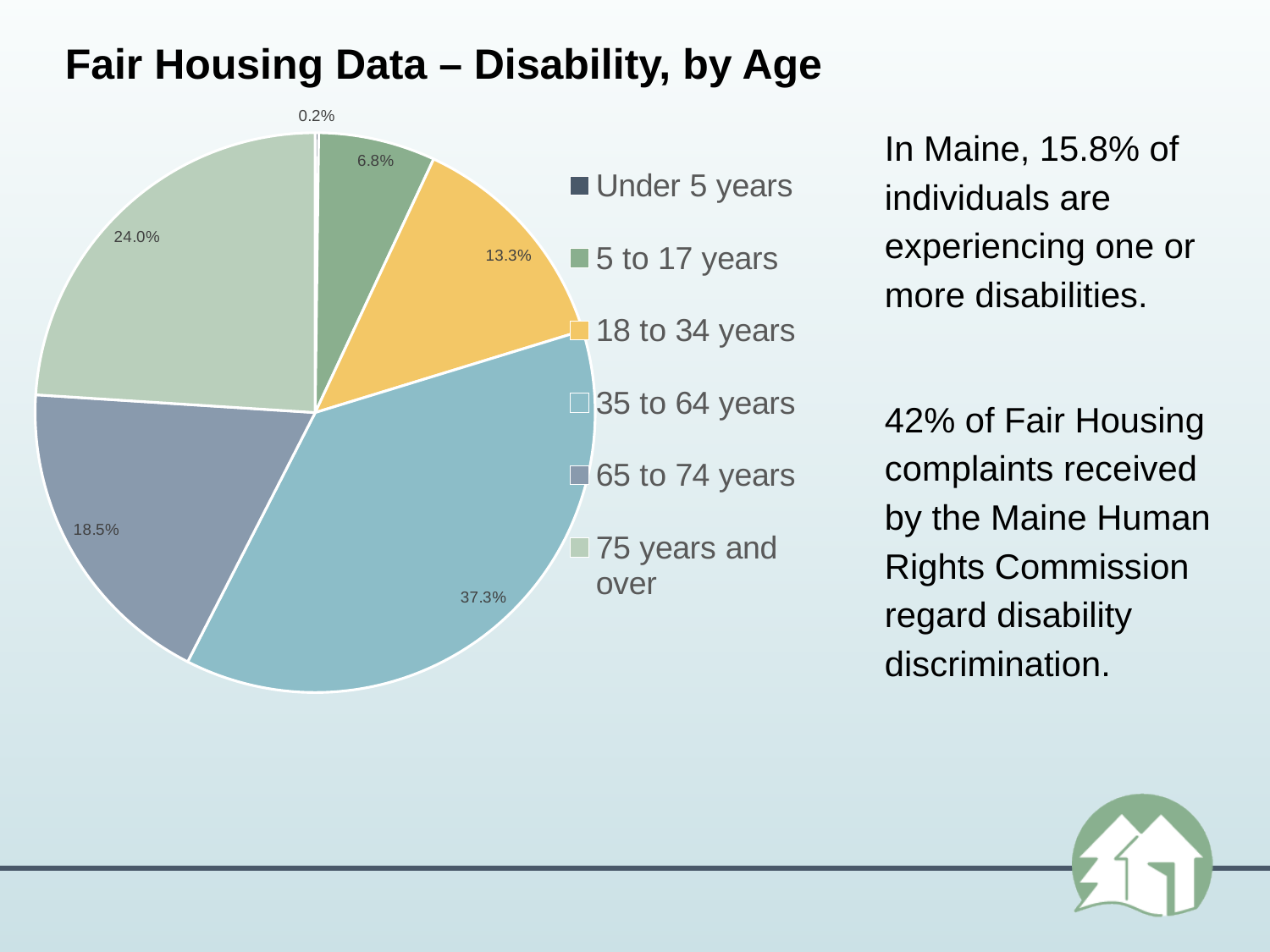
What kind of chart is shown on the slide? pie chart Which age group has the smallest share of the pie? Under 5 years Which is larger, the share for 75 years and over or the share for 65 to 74 years? 75 years and over What percentage is shown for the 75 years and over slice? 24.0% What colour is the 18 to 34 years slice in the pie chart? yellow What percentage of the pie is the 35 to 64 years slice? 37.3% Which age group has the largest share of the pie? 35 to 64 years What percentage is shown for the 18 to 34 years slice? 13.3% What is the title of the slide containing the pie chart? Fair Housing Data – Disability, by Age What percentage is shown for the Under 5 years slice? 0.2% What is the difference between the 65 to 74 years share and the 5 to 17 years share? 11.7% How many age groups are shown in the pie chart? 6